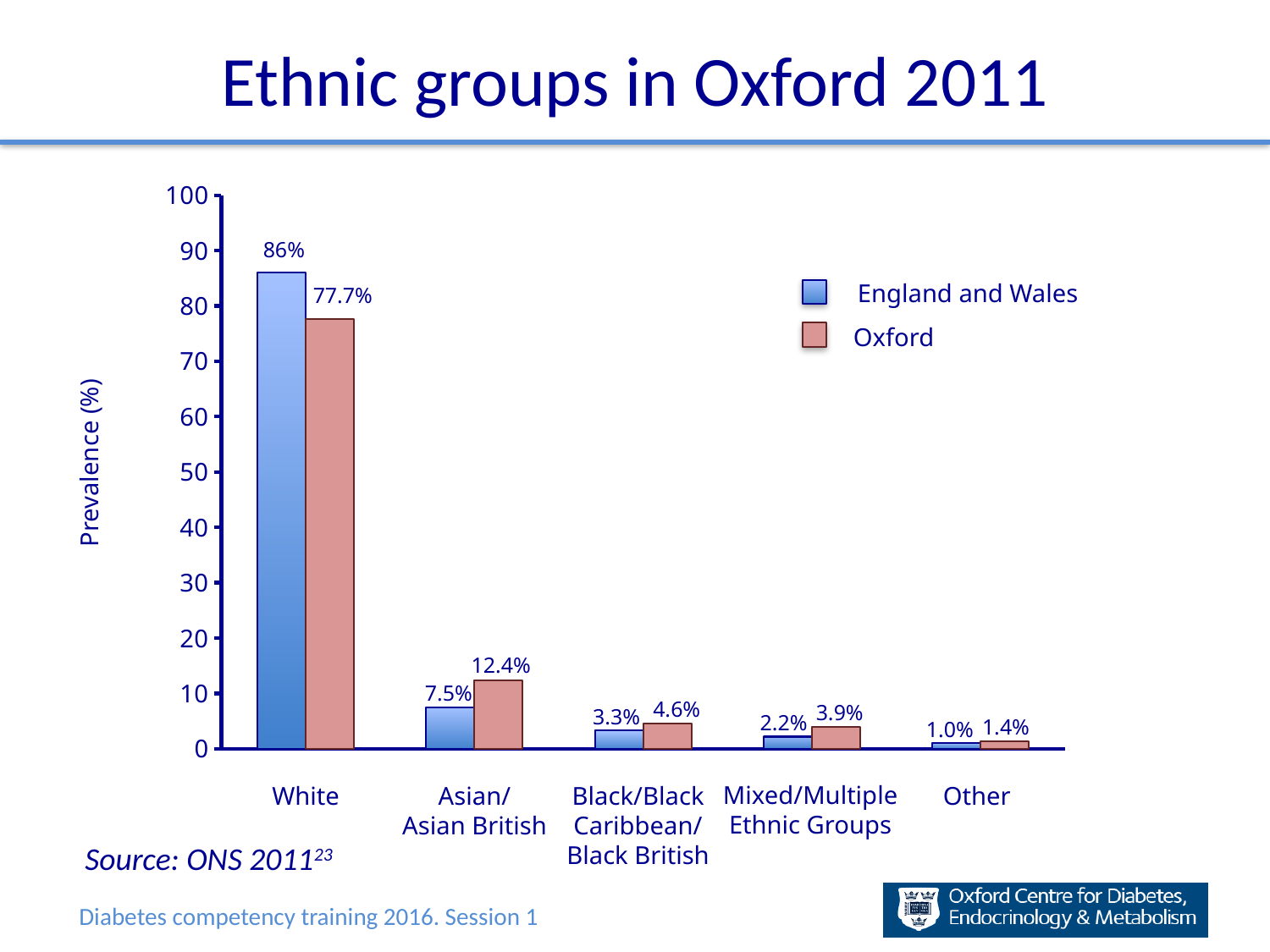
How many series does the legend list? 2 What kind of chart is shown on the slide? Bar chart What is the difference between the England and Wales and Oxford values for White? 8.3% Which is larger for Black/Black Caribbean/Black British: the England and Wales value or the Oxford value? Oxford What is the value for Asian/Asian British in the Oxford series? 12.4% Which ethnic group has the lowest value in the England and Wales series? Other How many ethnic group categories are shown on the x axis? 5 Which ethnic group has the highest value in the Oxford series? White What is the value for White in the England and Wales series? 86% What is the label of the y axis? Prevalence (%) What is the value for Mixed/Multiple Ethnic Groups in the England and Wales series? 2.2% What is the value for Other in the Oxford series? 1.4%